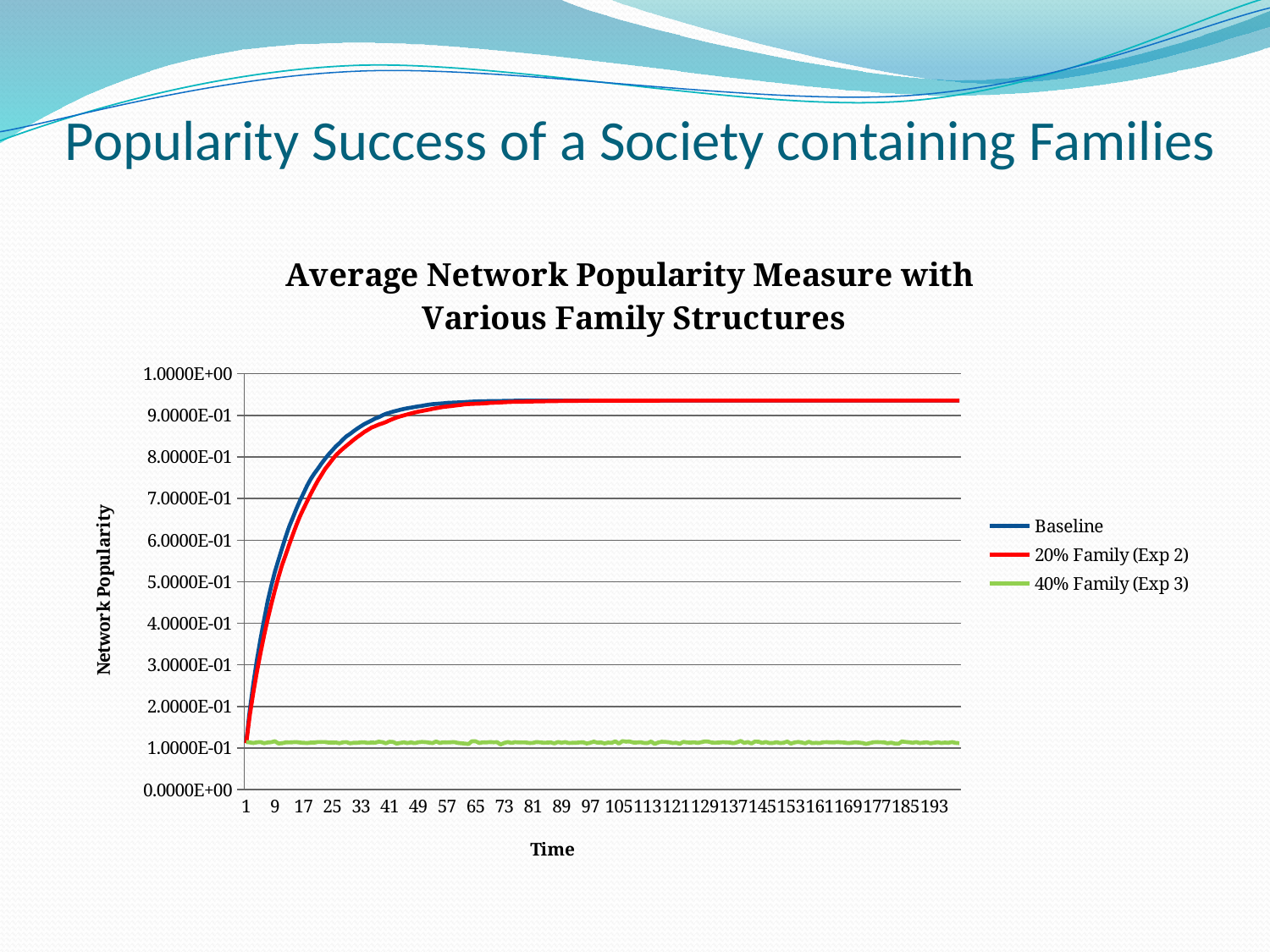
What is the title of the chart? Average Network Popularity Measure with Various Family Structures Is the value of the Baseline series at time 1 greater or less than 2.0000E-01? less At time 193, which series is higher: Baseline or 40% Family (Exp 3)? Baseline What kind of chart is shown on the slide? line chart Is the value of the 20% Family (Exp 2) series at time 193 greater or less than 8.0000E-01? greater What is the label of the vertical axis? Network Popularity Is the value of the 40% Family (Exp 3) series at time 97 greater or less than 2.0000E-01? less At time 25, which series is higher: Baseline or 20% Family (Exp 2)? Baseline Does the Baseline series rise or fall as time increases from 1 to 193? rise How many series does the legend list? 3 Which series has the lowest values across the whole time range? 40% Family (Exp 3)